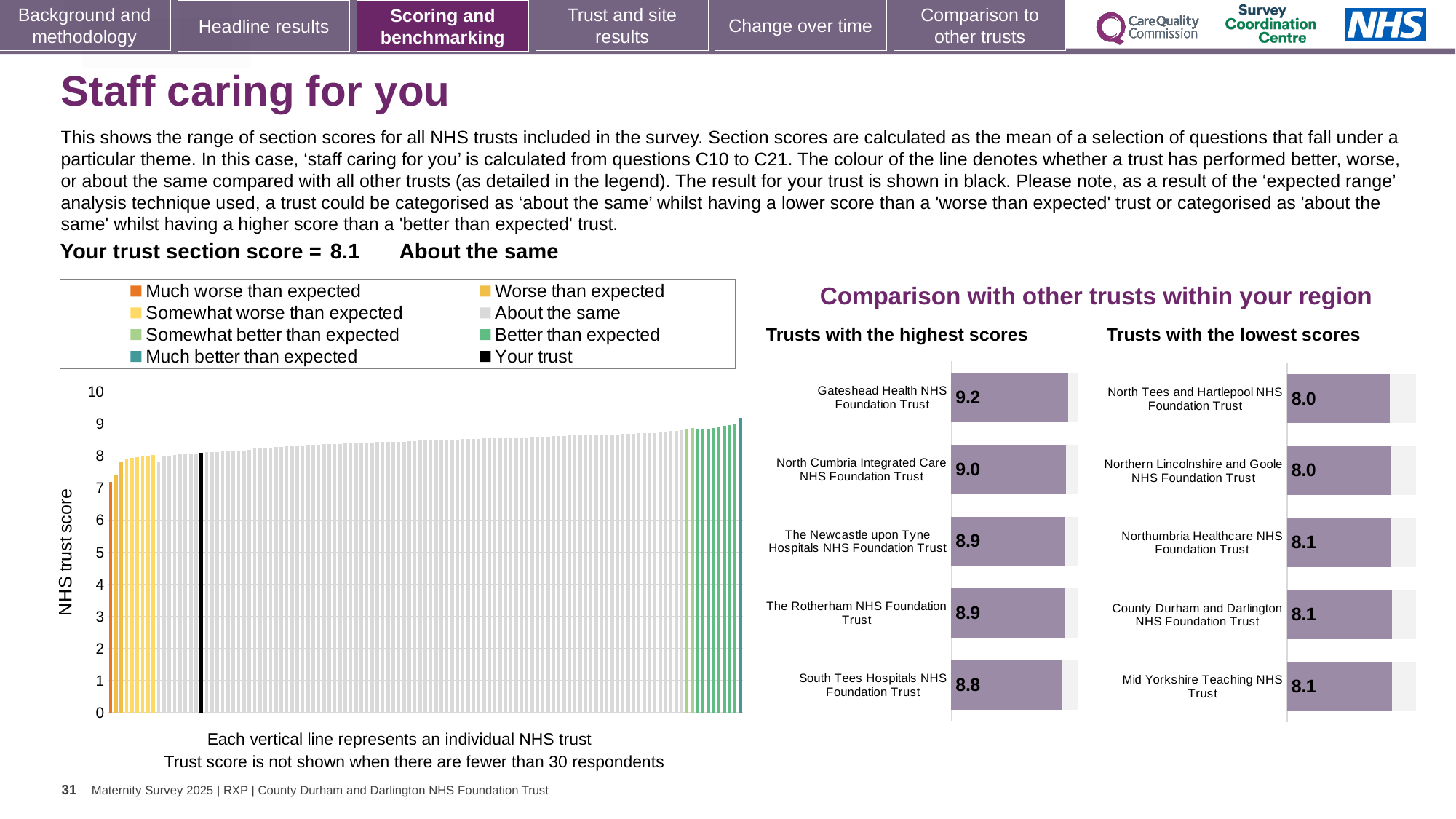
In the 'Trusts with the lowest scores' chart, which has the larger score: Northumbria Healthcare NHS Foundation Trust or North Tees and Hartlepool NHS Foundation Trust? Northumbria Healthcare NHS Foundation Trust In the 'Trusts with the lowest scores' chart, what is the difference between the scores of County Durham and Darlington NHS Foundation Trust and Northern Lincolnshire and Goole NHS Foundation Trust? 0.1 In the left-hand chart, do the trust scores rise or fall from left to right? Rise In the 'Trusts with the highest scores' chart, what is the difference between the scores of Gateshead Health NHS Foundation Trust and South Tees Hospitals NHS Foundation Trust? 0.4 In the 'Trusts with the lowest scores' chart, what is the score for Mid Yorkshire Teaching NHS Trust? 8.1 What kind of chart is the large chart on the left showing NHS trust scores? Bar chart What is the label on the vertical axis of the left-hand chart? NHS trust score In the 'Trusts with the highest scores' chart, which trust has the highest score? Gateshead Health NHS Foundation Trust In the 'Trusts with the highest scores' chart, how many trusts are shown? 5 In the 'Trusts with the highest scores' chart, what is the score for Gateshead Health NHS Foundation Trust? 9.2 How many entries does the legend above the left-hand chart list? 8 In the 'Trusts with the highest scores' chart, what is the score for South Tees Hospitals NHS Foundation Trust? 8.8